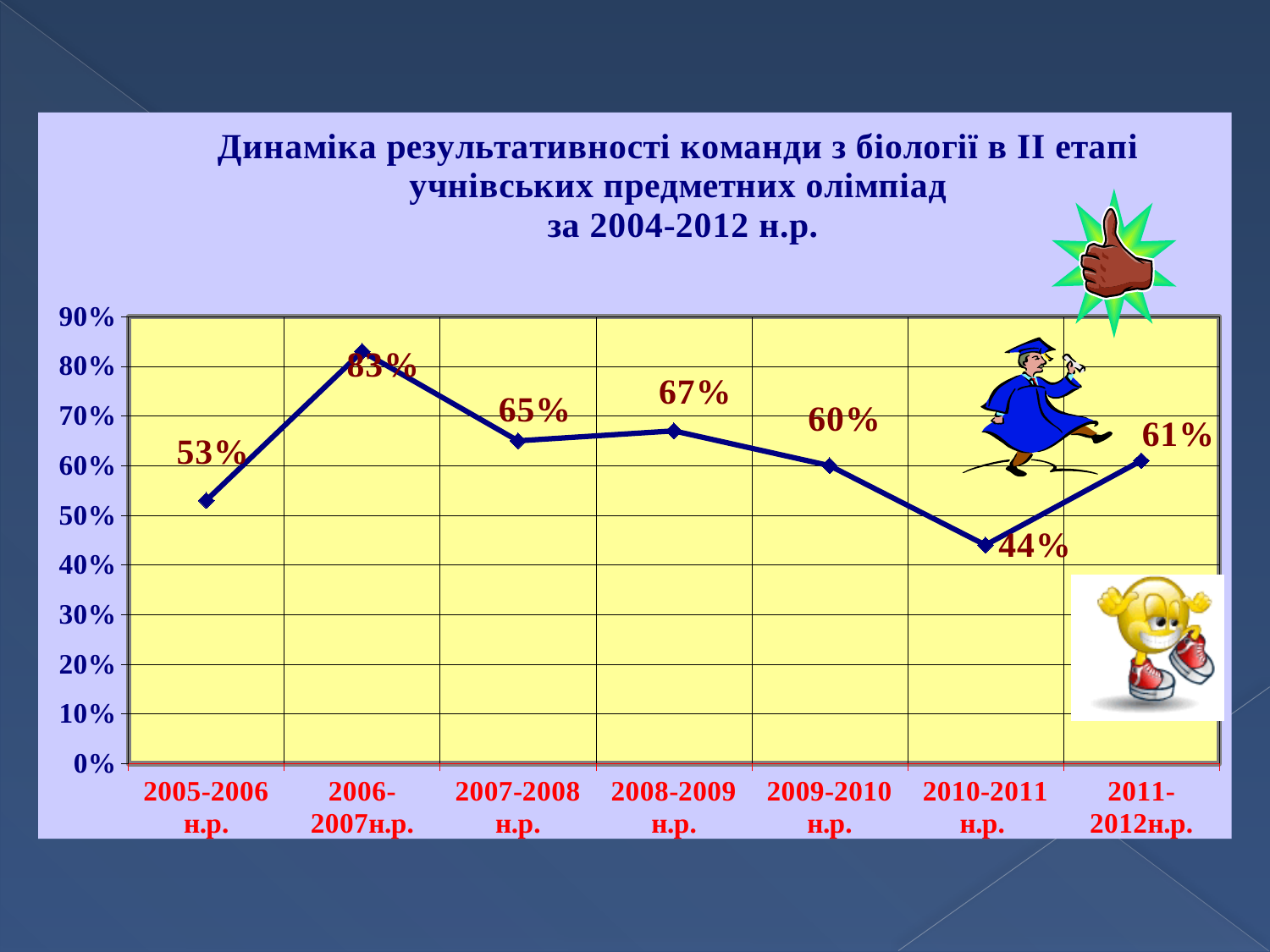
Is the value for 2006-2007 н.р. greater or less than 80%? greater What is the value for 2011-2012 н.р.? 61% What is the difference between the values for 2008-2009 н.р. and 2010-2011 н.р.? 23% Which academic year has the lowest value? 2010-2011 н.р. What is the value for 2010-2011 н.р.? 44% What is the value for 2008-2009 н.р.? 67% What kind of chart is shown on the slide? line chart What is the value for 2005-2006 н.р.? 53% Which is larger, the value for 2007-2008 н.р. or for 2009-2010 н.р.? 2007-2008 н.р. Which academic year has the highest value? 2006-2007 н.р. Does the value rise or fall from 2009-2010 н.р. to 2010-2011 н.р.? fall How many academic years are plotted on the chart? 7